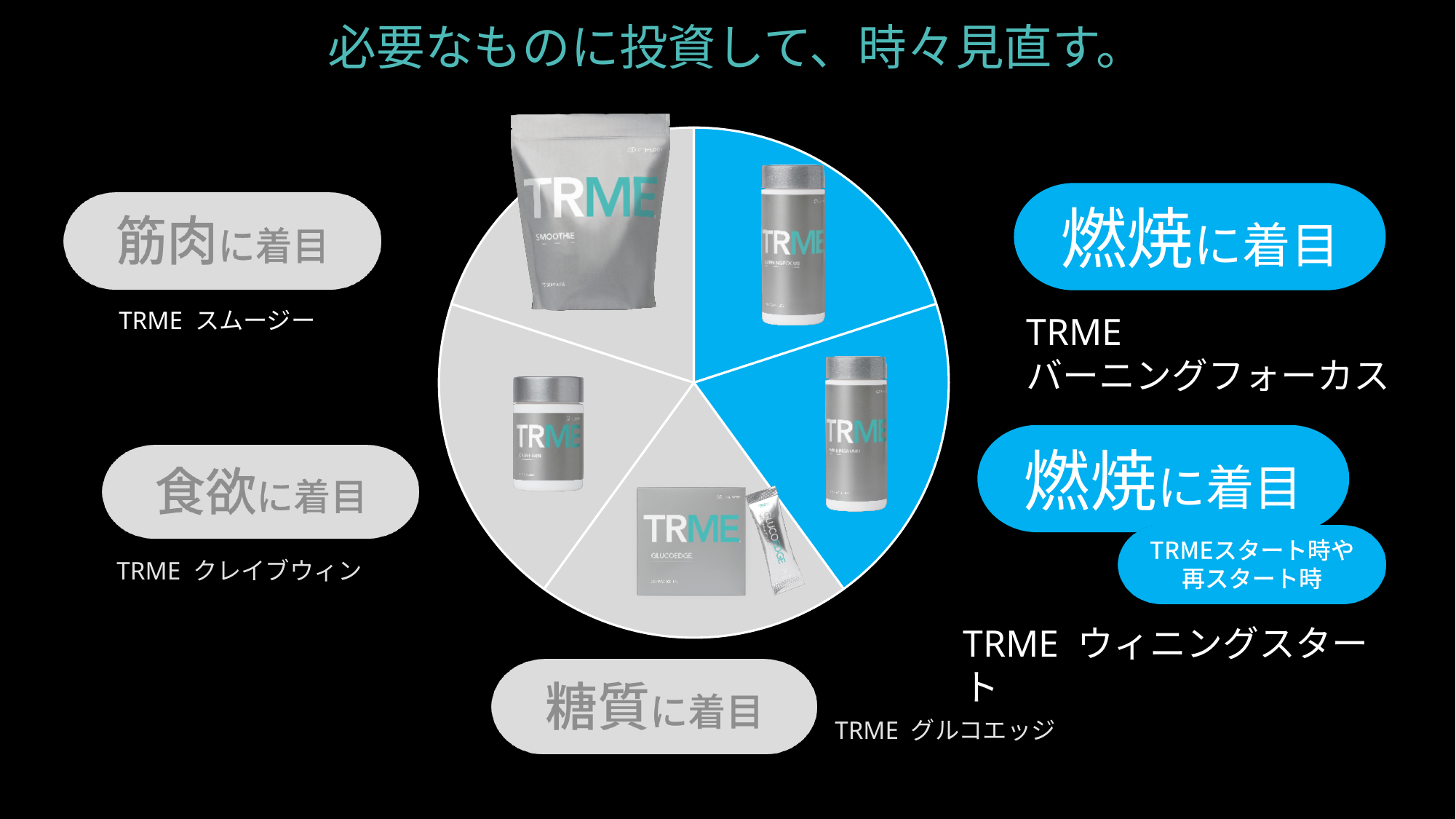
Which focus area do the blue slices of the pie chart represent? 燃焼に着目 How many slices of the pie chart are coloured blue? 2 How many slices does the pie chart have? 5 Which product is shown in the pie chart slice labelled 食欲に着目? TRME クレイブウィン Which product is shown in the pie chart slice labelled 糖質に着目? TRME グルコエッジ Which product is shown in the pie chart slice labelled 筋肉に着目? TRME スムージー How many products on the pie chart are labelled as focusing on 燃焼 (burning)? 2 What kind of chart is shown on the slide? pie chart